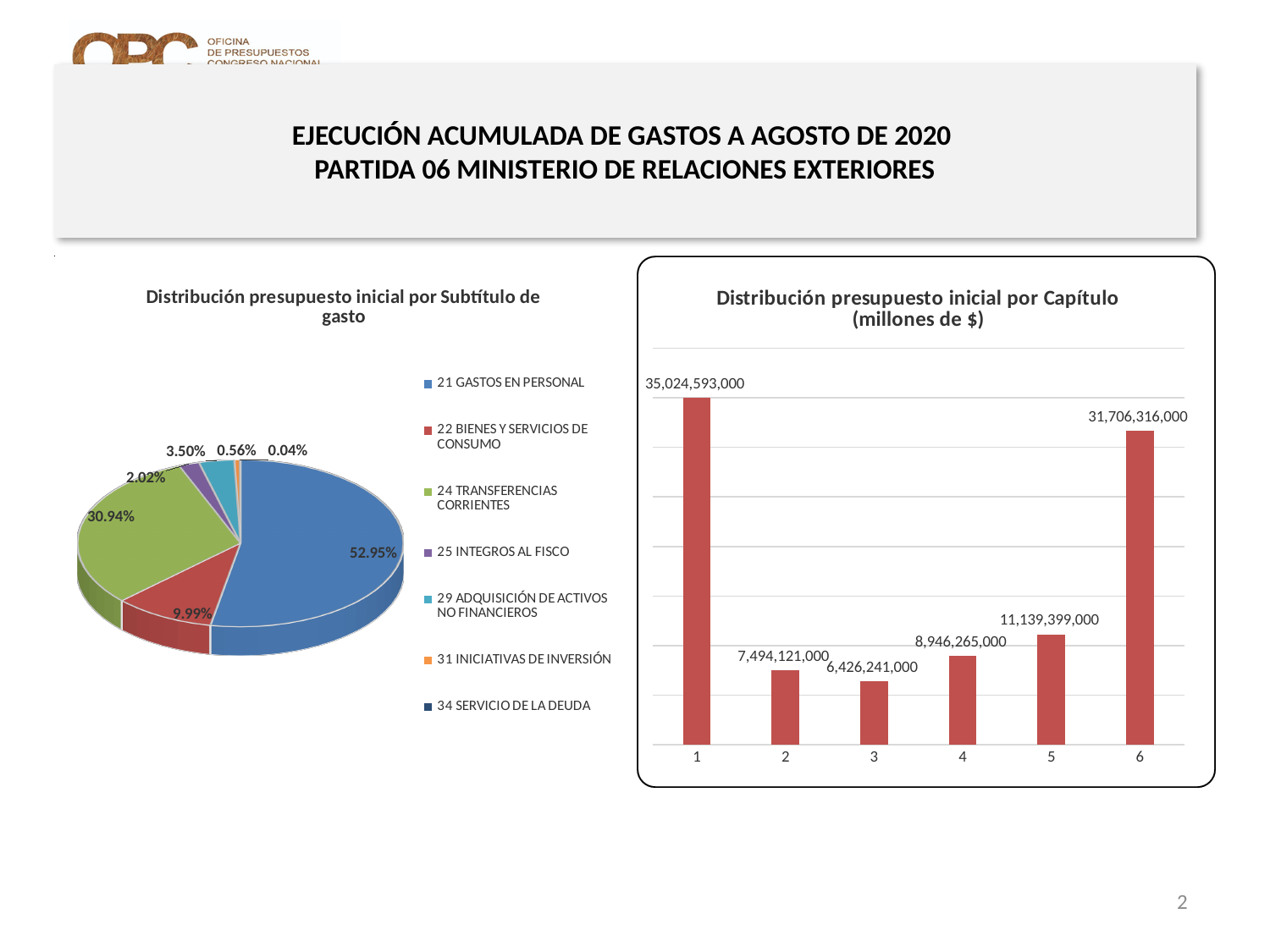
In the 'Distribución presupuesto inicial por Subtítulo de gasto' chart, what share does '24 TRANSFERENCIAS CORRIENTES' have? 30.94% In the 'Distribución presupuesto inicial por Capítulo' chart, which category has the highest value? 1 In the 'Distribución presupuesto inicial por Capítulo' chart, which is larger, the value for category 2 or category 4? Category 4 In the 'Distribución presupuesto inicial por Subtítulo de gasto' chart, what share does '21 GASTOS EN PERSONAL' have? 52.95% In the 'Distribución presupuesto inicial por Subtítulo de gasto' chart, which subtítulo has the smallest share? 34 SERVICIO DE LA DEUDA In the 'Distribución presupuesto inicial por Capítulo' chart, what is the value for category 1? 35,024,593,000 What kind of chart is 'Distribución presupuesto inicial por Capítulo'? Bar chart In the 'Distribución presupuesto inicial por Capítulo' chart, which category has the lowest value? 3 How many categories are shown in the 'Distribución presupuesto inicial por Capítulo' chart? 6 How many entries does the legend of the 'Distribución presupuesto inicial por Subtítulo de gasto' chart list? 7 In the 'Distribución presupuesto inicial por Capítulo' chart, what is the difference between the values for category 1 and category 6? 3,318,277,000 In the 'Distribución presupuesto inicial por Capítulo' chart, what is the value for category 5? 11,139,399,000